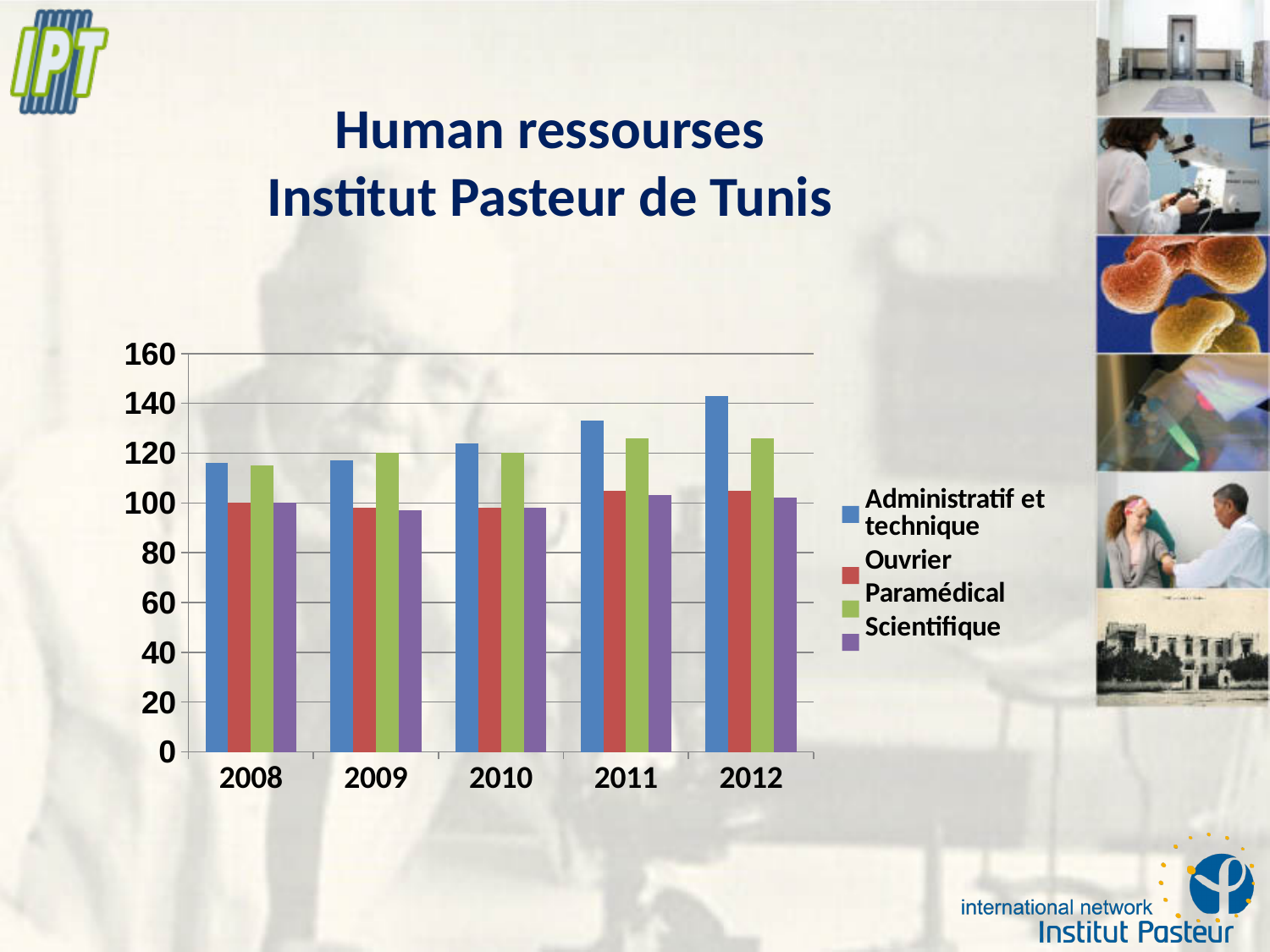
How many years are shown on the x axis of the chart? 5 Which colour represents the Paramédical series in the chart? green Does the Administratif et technique series rise or fall from 2008 to 2012? rise In 2012, which is larger: Administratif et technique or Paramédical? Administratif et technique Is the value for Paramédical in 2011 greater or less than 120? greater Is the value for Administratif et technique in 2012 greater or less than 120? greater Is the value for Scientifique in 2010 greater or less than 120? less Which series has the highest bar in 2012? Administratif et technique What kind of chart is shown on the slide? bar chart Which series has the highest bar in 2011? Administratif et technique How many series does the chart's legend list? 4